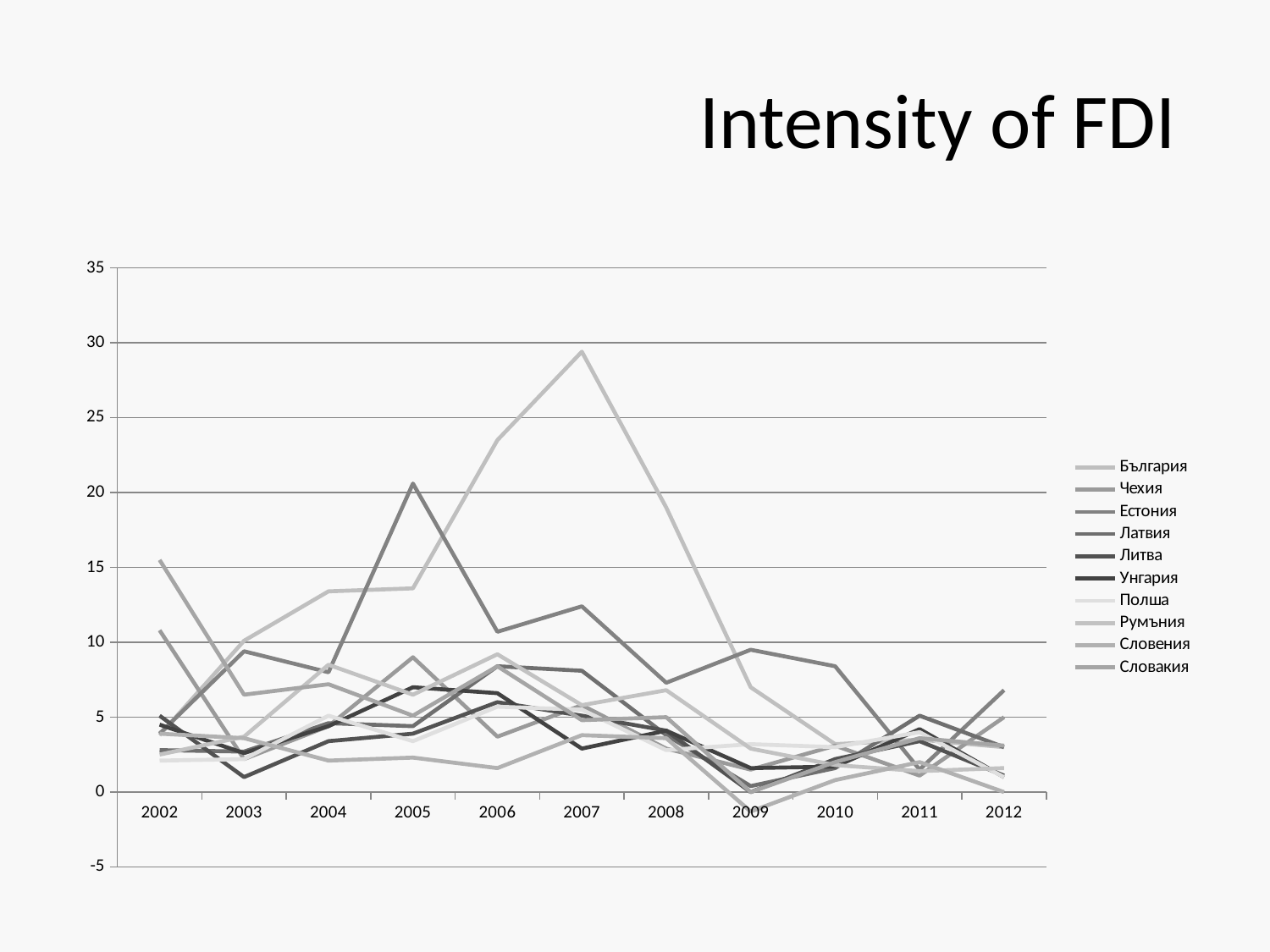
What kind of chart is shown on the slide? line chart How many years are shown along the x axis? 11 In which year does the highest point on the chart occur? 2007 What is the maximum value shown on the y axis? 35 What is the last year shown on the x axis? 2012 How many series does the legend list? 10 What is the minimum value shown on the y axis? -5 Is the highest point on the chart greater or less than 30? less Is the highest point on the chart greater or less than 25? greater